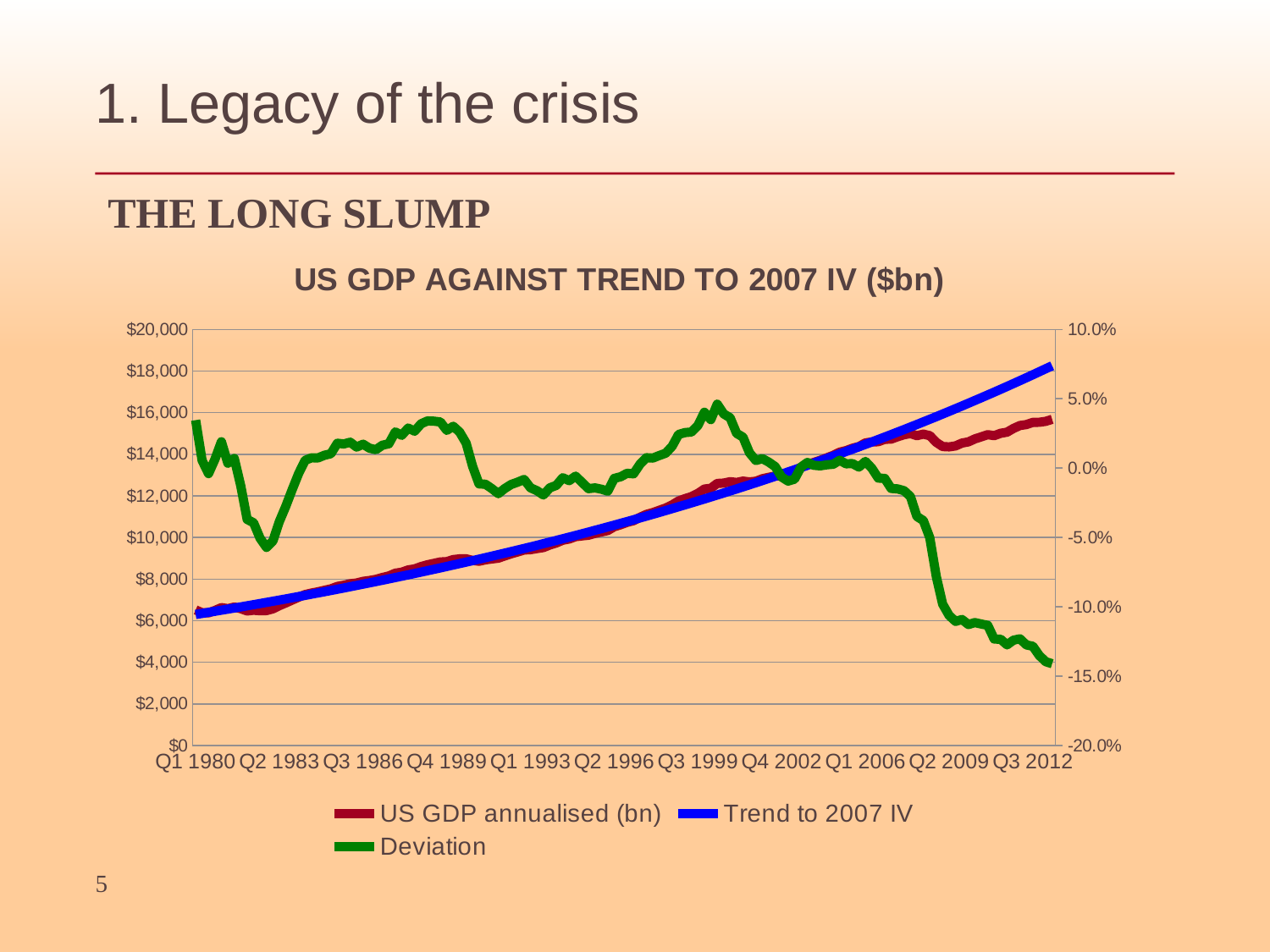
Which series is drawn in green? Deviation Does the Deviation series rise or fall between Q1 2006 and Q3 2012? fall Does the US GDP annualised (bn) series generally rise or fall from Q1 1980 to Q3 2012? rise How many series does the legend list? 3 What kind of chart is shown on the slide? line chart What is the title of the chart? US GDP AGAINST TREND TO 2007 IV ($bn) Is the value of Trend to 2007 IV at Q3 2012 greater or less than $16,000? greater How many labels are shown on the x axis? 11 Is the Deviation value at Q3 2012 greater or less than -10.0%? less At Q3 2012, which is higher: the Trend to 2007 IV line or the US GDP annualised (bn) line? Trend to 2007 IV Is the Deviation value at Q3 1999 greater or less than 0.0%? greater